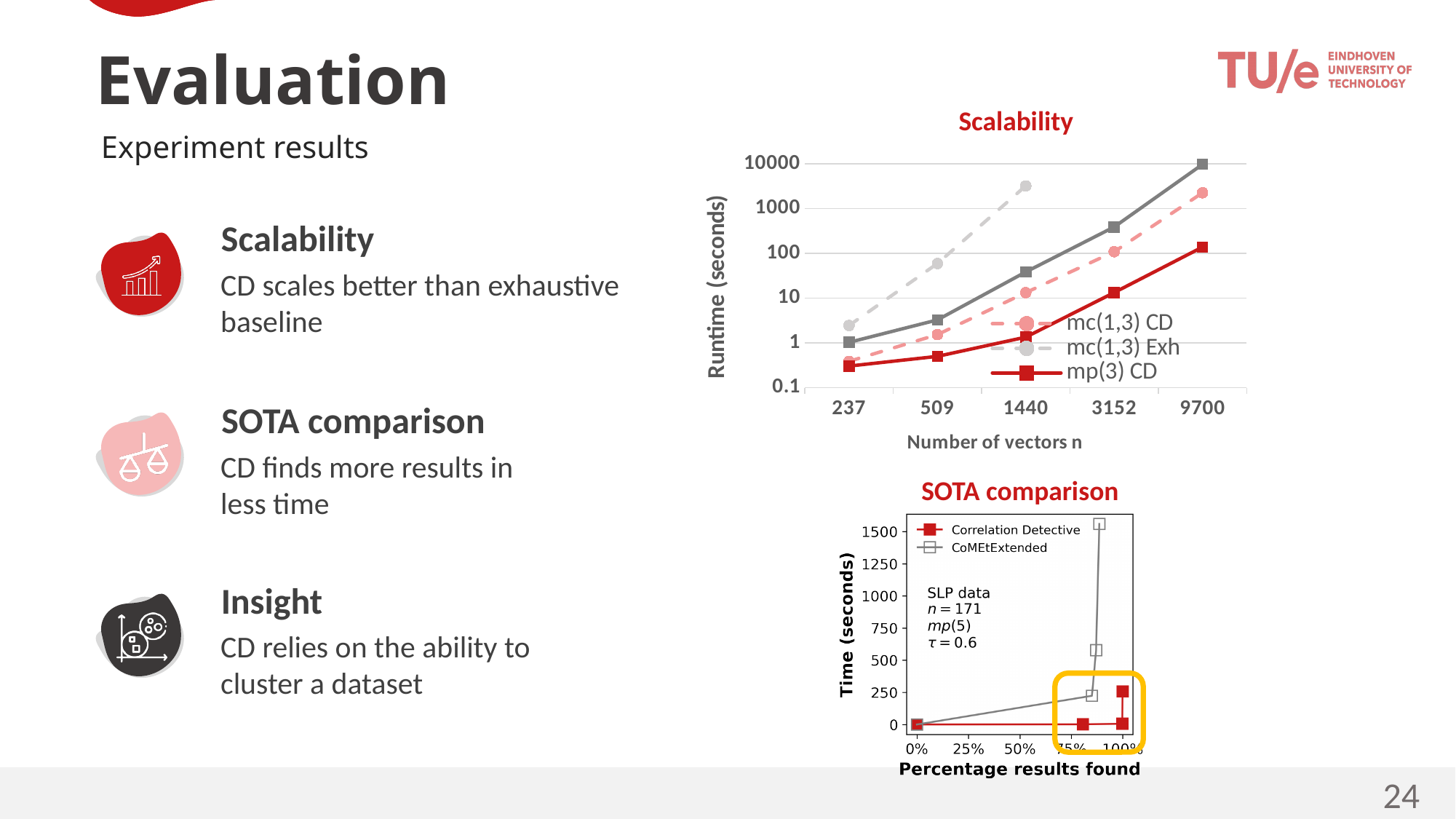
In the Scalability chart, is the runtime of mc(1,3) Exh at n = 1440 greater or less than 1000 seconds? greater In the Scalability chart, what kind of chart is shown? line chart In the Scalability chart, is the runtime of mp(3) CD at n = 9700 greater or less than 100 seconds? greater In the Scalability chart, how many series does the legend list? 3 In the Scalability chart, at n = 1440, which has the higher runtime: mc(1,3) Exh or mp(3) CD? mc(1,3) Exh In the Scalability chart, is the runtime of mp(3) CD at n = 237 greater or less than 1 second? less In the Scalability chart, does the runtime of mp(3) CD rise or fall as the number of vectors n increases? rise In the SOTA comparison chart, how many series does the legend list? 2 In the Scalability chart, what is the label of the x axis? Number of vectors n In the Scalability chart, how many values of n are shown on the x axis? 5